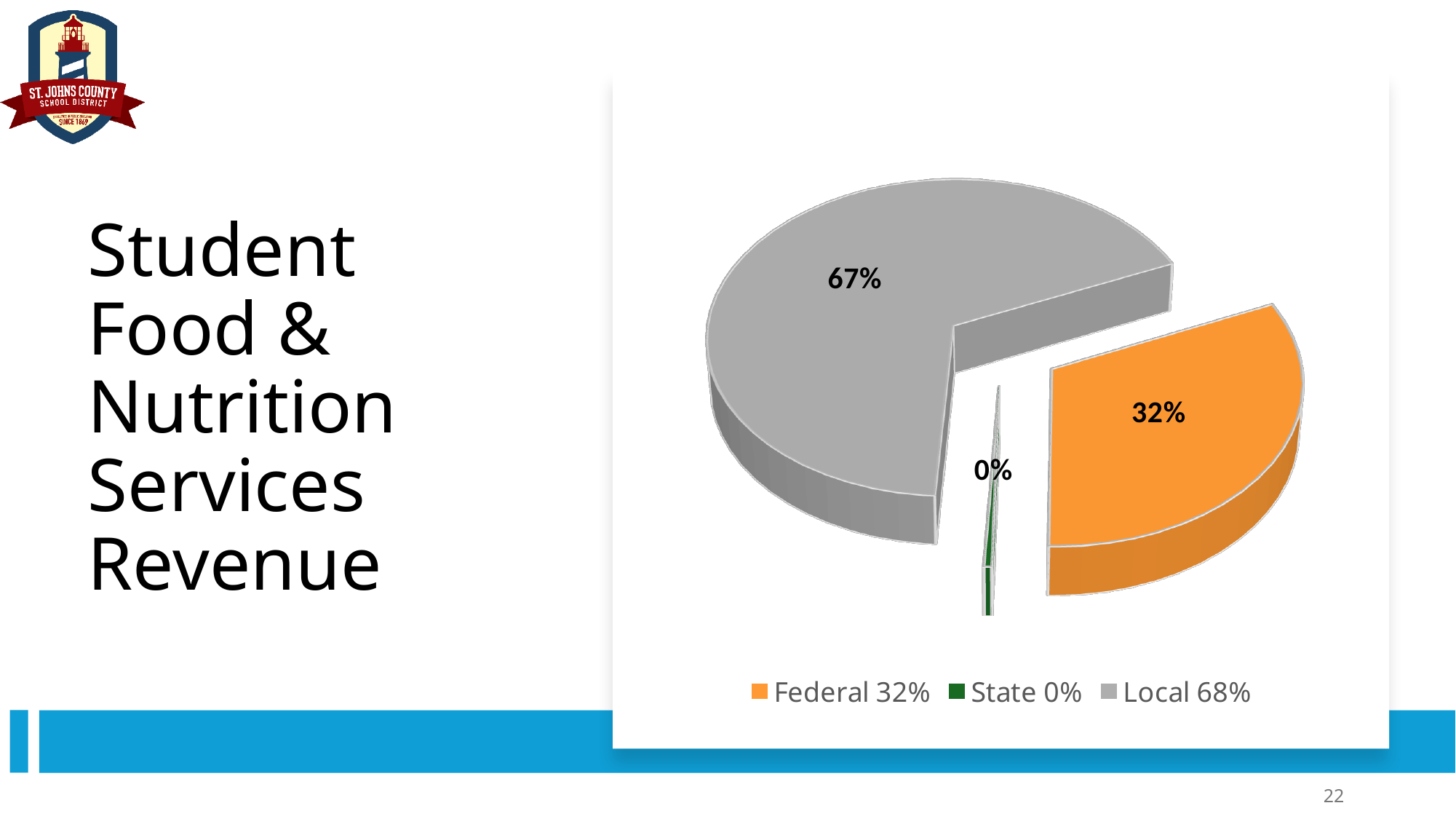
What percentage does the legend give for Local? 68% What is the difference between the Federal share and the State share? 32% Which revenue source has the largest share of the pie? Local What kind of chart is shown on the slide? pie chart What share of the revenue comes from State sources? 0% Which is larger, the Federal share or the Local share? Local What are the three entries listed in the chart legend? Federal 32%, State 0%, Local 68% Which revenue source has the smallest share of the pie? State What percentage is printed as the data label on the grey (Local) slice? 67% What share of Student Food & Nutrition Services Revenue comes from Federal sources? 32% How many slices does the pie chart have? 3 What is the title of the slide containing the pie chart? Student Food & Nutrition Services Revenue